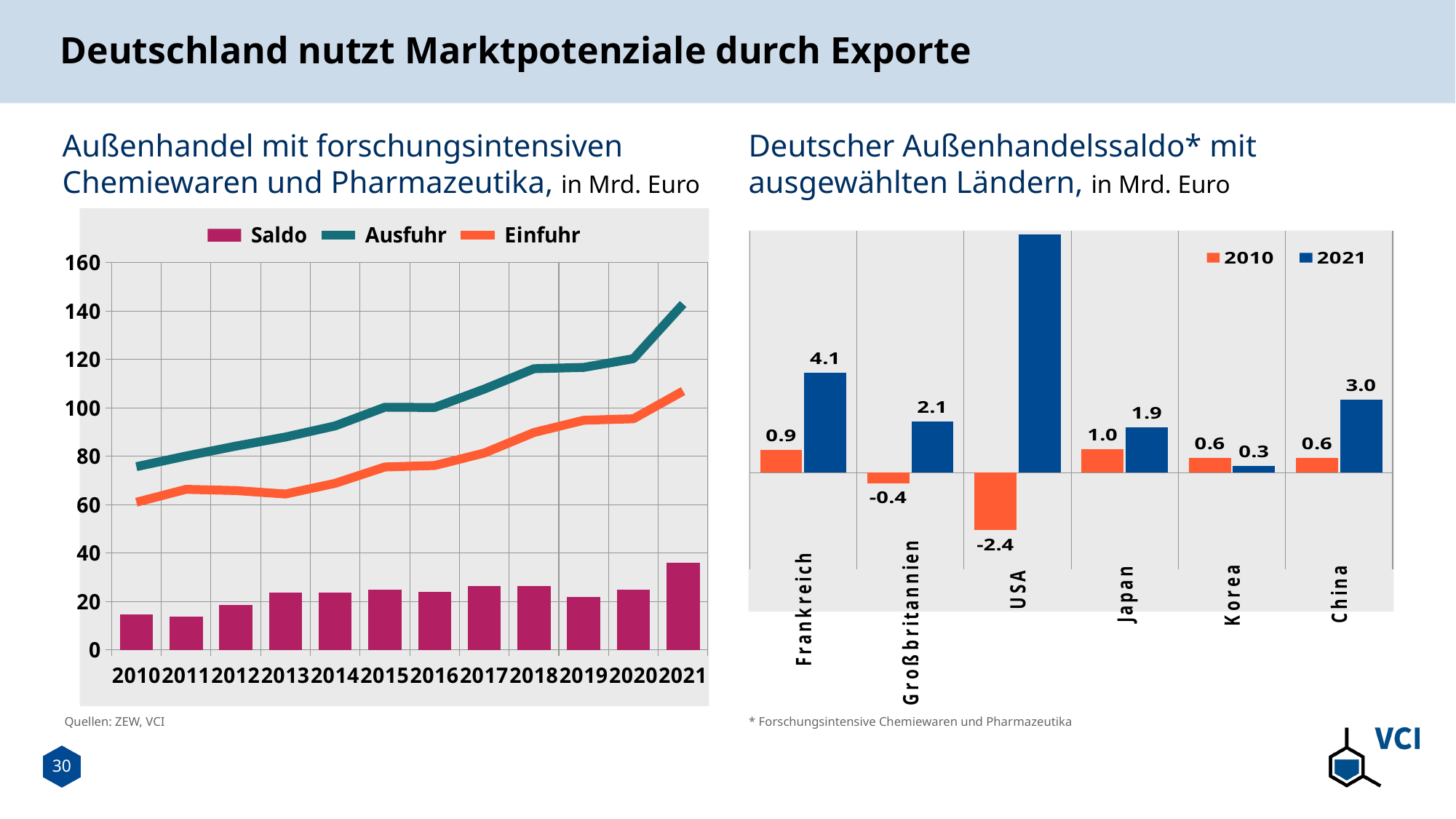
In the left chart, 'Außenhandel mit forschungsintensiven Chemiewaren und Pharmazeutika', is the Einfuhr value for 2021 greater or less than 100? greater In the left chart, 'Außenhandel mit forschungsintensiven Chemiewaren und Pharmazeutika', is the Saldo value for 2021 greater or less than 40? less In the left chart, 'Außenhandel mit forschungsintensiven Chemiewaren und Pharmazeutika', does the Ausfuhr line rise or fall from 2010 to 2021? Rises In the right chart, 'Deutscher Außenhandelssaldo mit ausgewählten Ländern', which country has the lowest value for 2010? USA In the left chart, 'Außenhandel mit forschungsintensiven Chemiewaren und Pharmazeutika', how many series does the legend list? 3 In the right chart, 'Deutscher Außenhandelssaldo mit ausgewählten Ländern', what is the value for USA in 2010? -2.4 In the left chart, 'Außenhandel mit forschungsintensiven Chemiewaren und Pharmazeutika', how many years are shown on the x axis? 12 In the left chart, 'Außenhandel mit forschungsintensiven Chemiewaren und Pharmazeutika', in which year is the Saldo bar highest? 2021 In the right chart, 'Deutscher Außenhandelssaldo mit ausgewählten Ländern', how many countries are shown? 6 What type of chart is the left chart, 'Außenhandel mit forschungsintensiven Chemiewaren und Pharmazeutika'? Combined line and bar chart In the right chart, 'Deutscher Außenhandelssaldo mit ausgewählten Ländern', what is the value for Frankreich in 2021? 4.1 In the right chart, 'Deutscher Außenhandelssaldo mit ausgewählten Ländern', what is the difference between the 2021 and 2010 values for Frankreich? 3.2